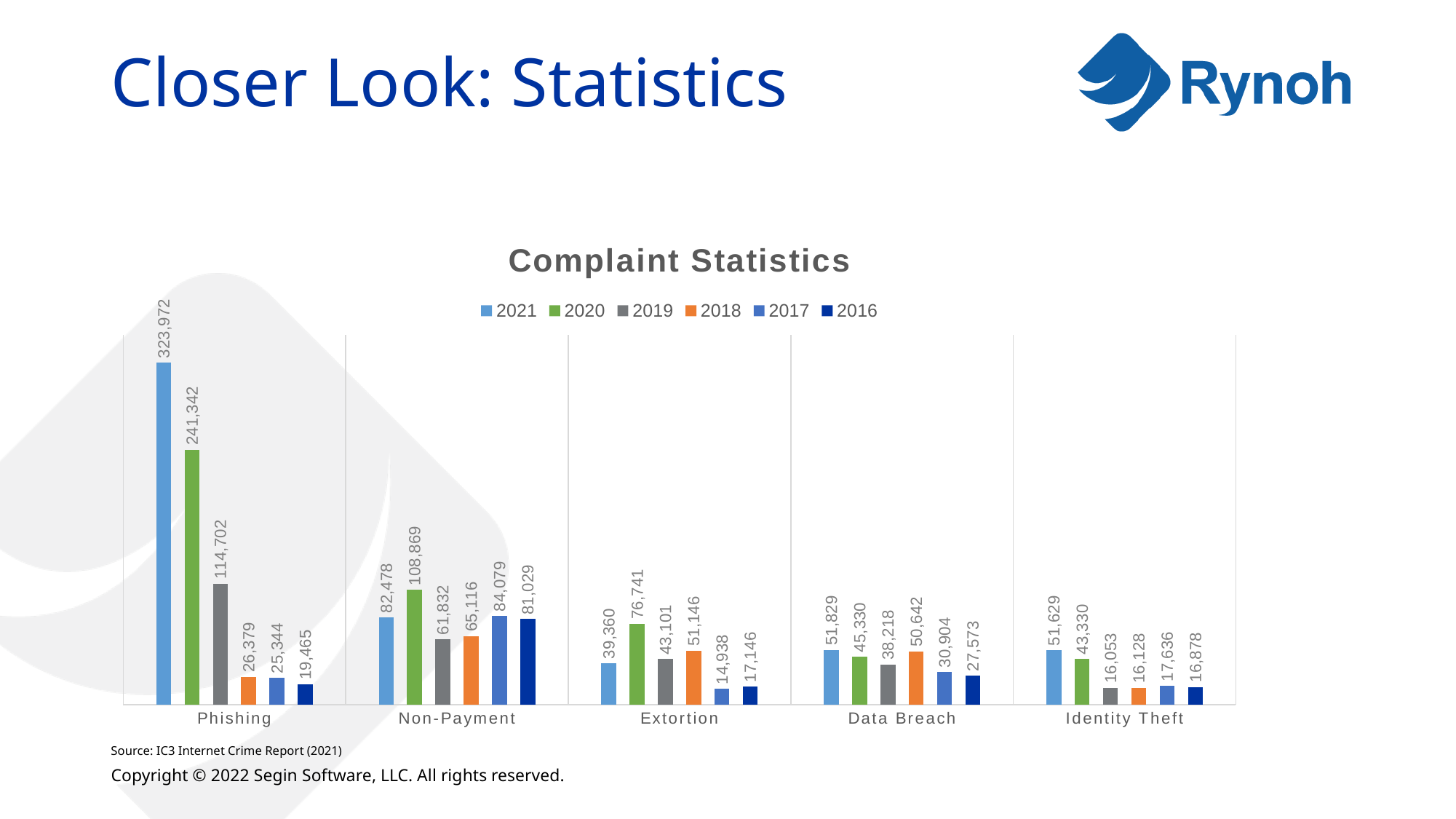
Which category has the highest value for 2021? Phishing What is the difference between the 2020 and 2019 values for Non-Payment? 47,037 What is the number of Phishing complaints for 2021? 323,972 What is the value for Non-Payment in 2020? 108,869 What kind of chart is shown on the slide? Bar chart Which category has the lowest value for 2021? Extortion What is the value for Extortion in 2018? 51,146 How many complaint categories are shown on the x axis? 5 For Data Breach, which year has the larger value, 2021 or 2018? 2021 What is the difference between the 2021 and 2020 values for Phishing? 82,630 How many series does the legend list? 6 What is the value for Identity Theft in 2016? 16,878